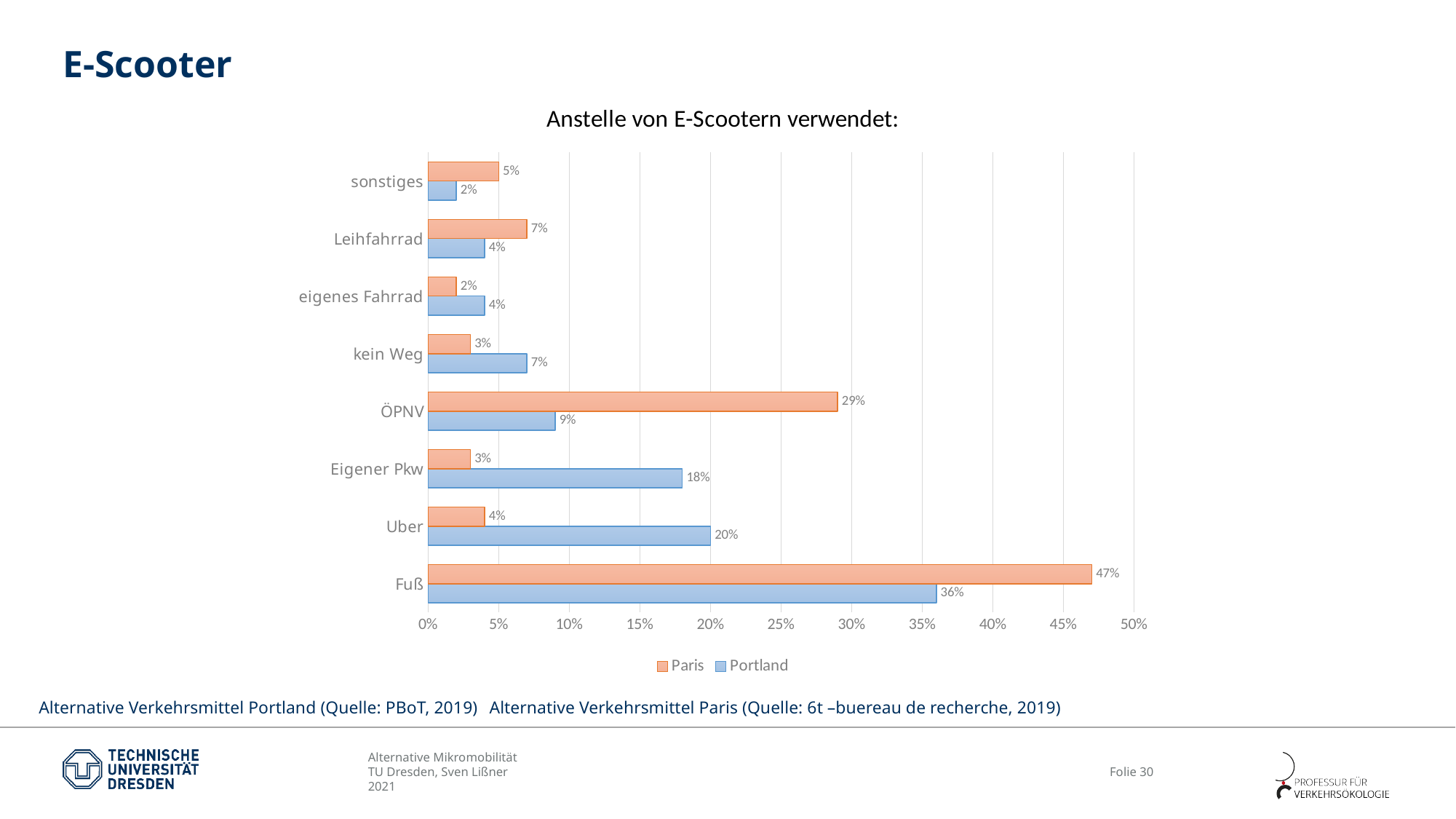
What is the value for Portland in the Uber category? 20% What kind of chart is shown on the slide? bar chart Which category has the lowest value for Paris? eigenes Fahrrad How many series does the legend list? 2 How many categories are shown on the y axis? 8 What is the difference between the Portland and Paris values for Eigener Pkw? 15% What is the title of the chart? Anstelle von E-Scootern verwendet: What is the difference between the Paris and Portland values for ÖPNV? 20% What is the value for Portland in the ÖPNV category? 9% Which is larger for kein Weg, the Paris value or the Portland value? Portland Which category has the highest value for Portland? Fuß What is the value for Paris in the Fuß category? 47%